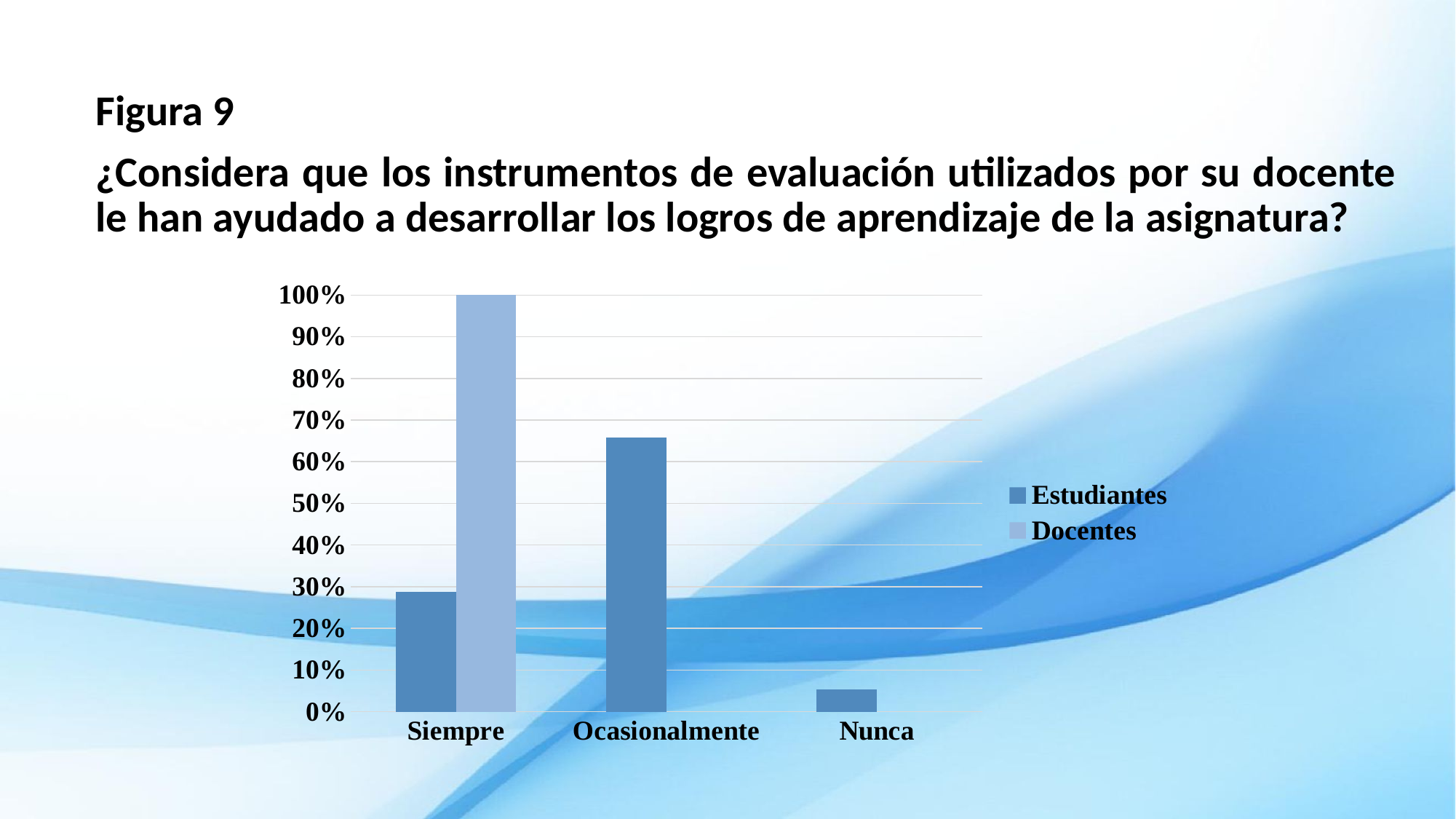
What kind of chart is shown on the slide? bar chart Which category has the lowest value for Estudiantes? Nunca What are the two series listed in the chart's legend? Estudiantes and Docentes In the Siempre category, which series has the larger value, Estudiantes or Docentes? Docentes Is the value for Estudiantes in the Nunca category greater or less than 10%? less Is the value for Estudiantes in the Ocasionalmente category greater or less than 60%? greater What is the value for Docentes in the Siempre category? 100% Which category has the highest value for Estudiantes? Ocasionalmente How many series does the chart's legend list? 2 How many categories are shown on the x axis of the chart? 3 Is the value for Estudiantes in the Siempre category greater or less than 40%? less For Estudiantes, which is larger, the value for Siempre or the value for Ocasionalmente? Ocasionalmente